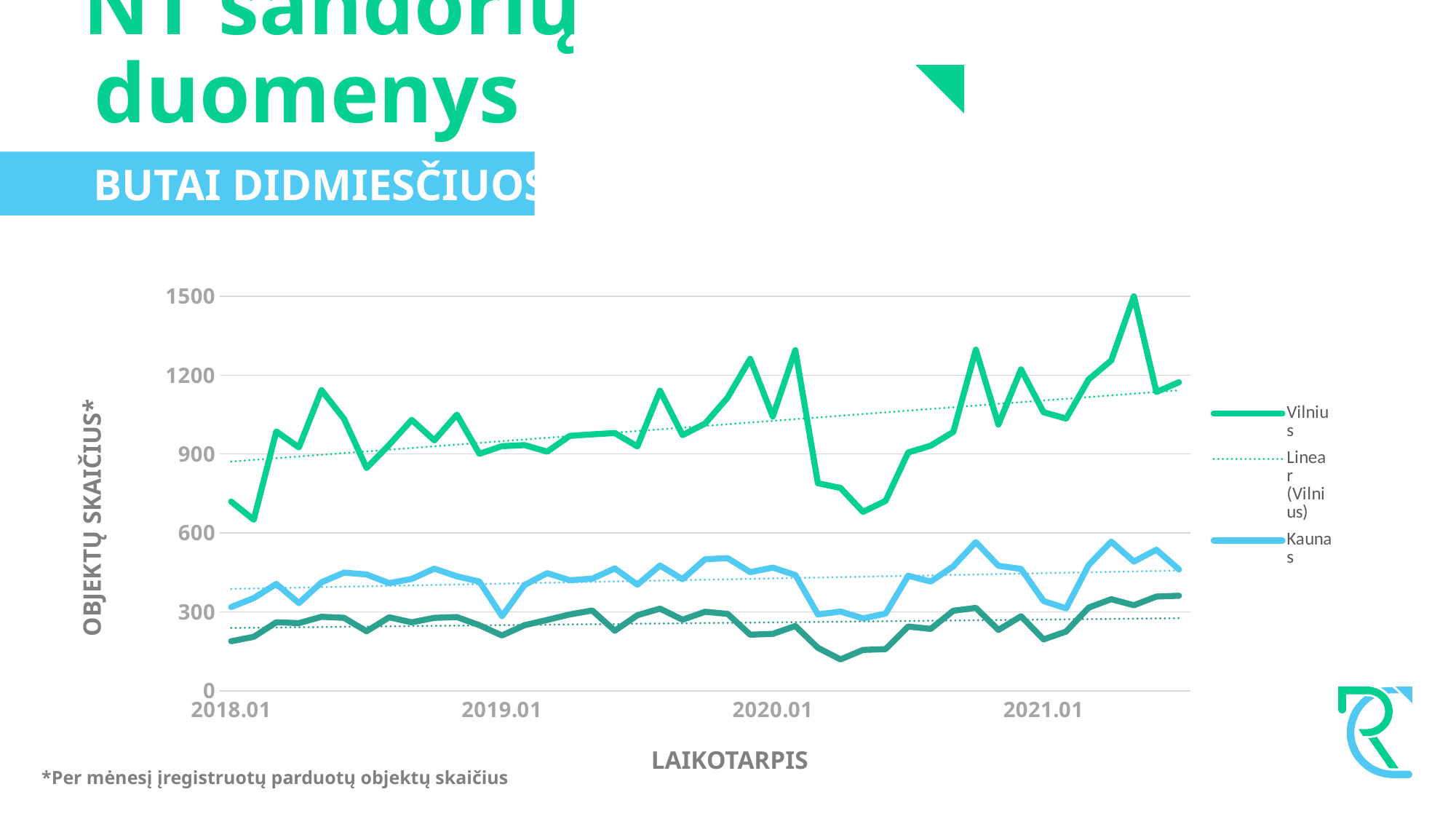
What is the title of the horizontal axis? LAIKOTARPIS What is the highest value shown on the vertical axis? 1500 Is the value for Kaunas at 2021.01 greater or less than 600? less Which series has the highest values throughout the chart, Vilnius or Kaunas? Vilnius Is the value for Kaunas at 2020.01 greater or less than 600? less Is the value for Vilnius at 2018.01 greater or less than 600? greater At 2021.01, which series has the larger value, Vilnius or Kaunas? Vilnius What kind of chart is shown on the slide? line chart What is the title of the vertical axis? OBJEKTŲ SKAIČIUS* Does the Linear (Vilnius) trend line rise or fall from left to right? rise